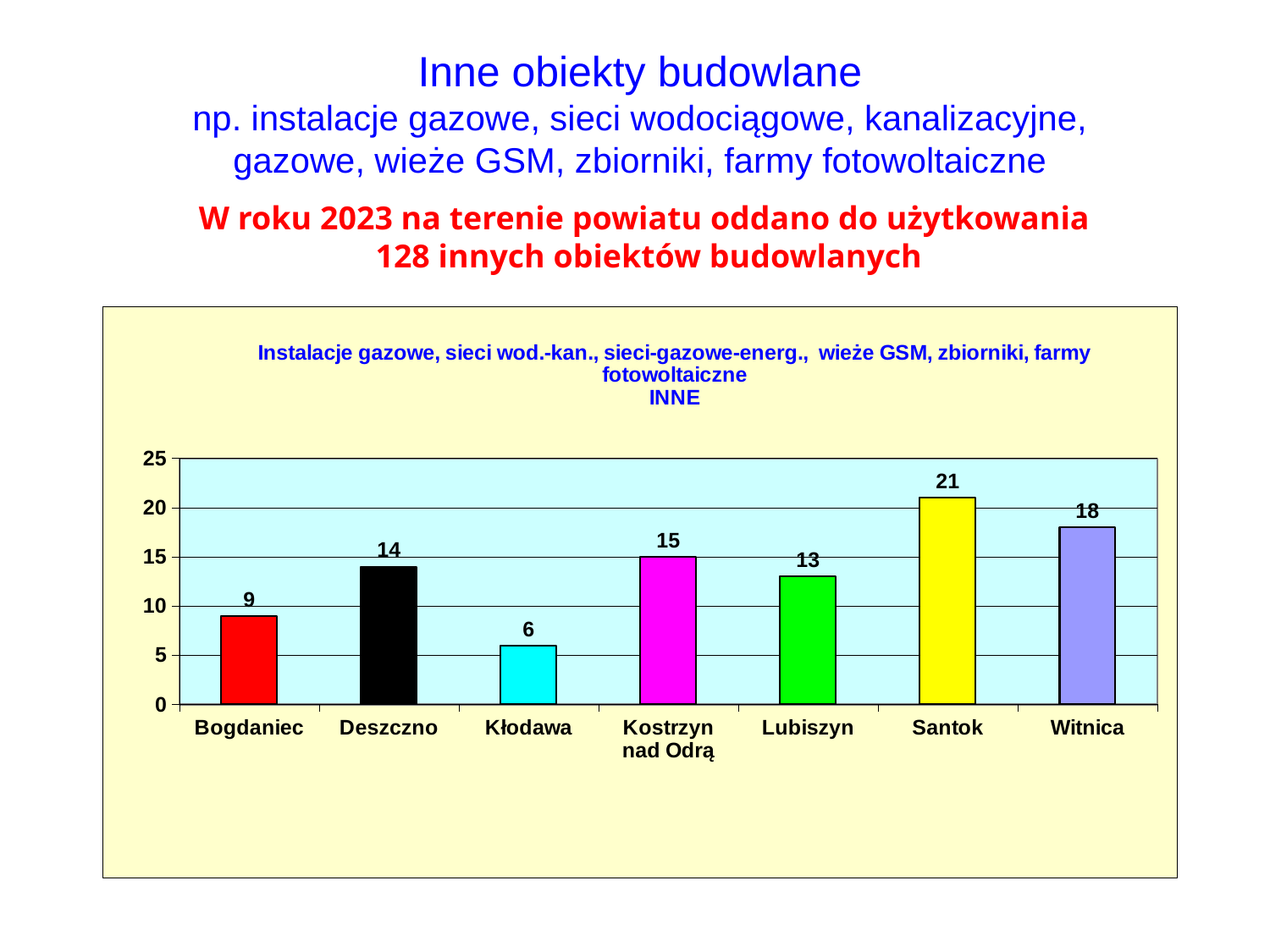
What kind of chart is shown on the slide? bar chart What is the difference between the values for Santok and Bogdaniec? 12 Is the value for Witnica greater or less than 15? greater How many categories are shown on the x axis? 7 What colour is the bar for Santok? yellow What is the difference between the values for Witnica and Kłodawa? 12 Which is larger, the value for Deszczno or the value for Lubiszyn? Deszczno What is the value for Kostrzyn nad Odrą? 15 What is the value for Kłodawa? 6 What is the value for Santok? 21 Which category has the lowest value? Kłodawa Which category has the highest value? Santok